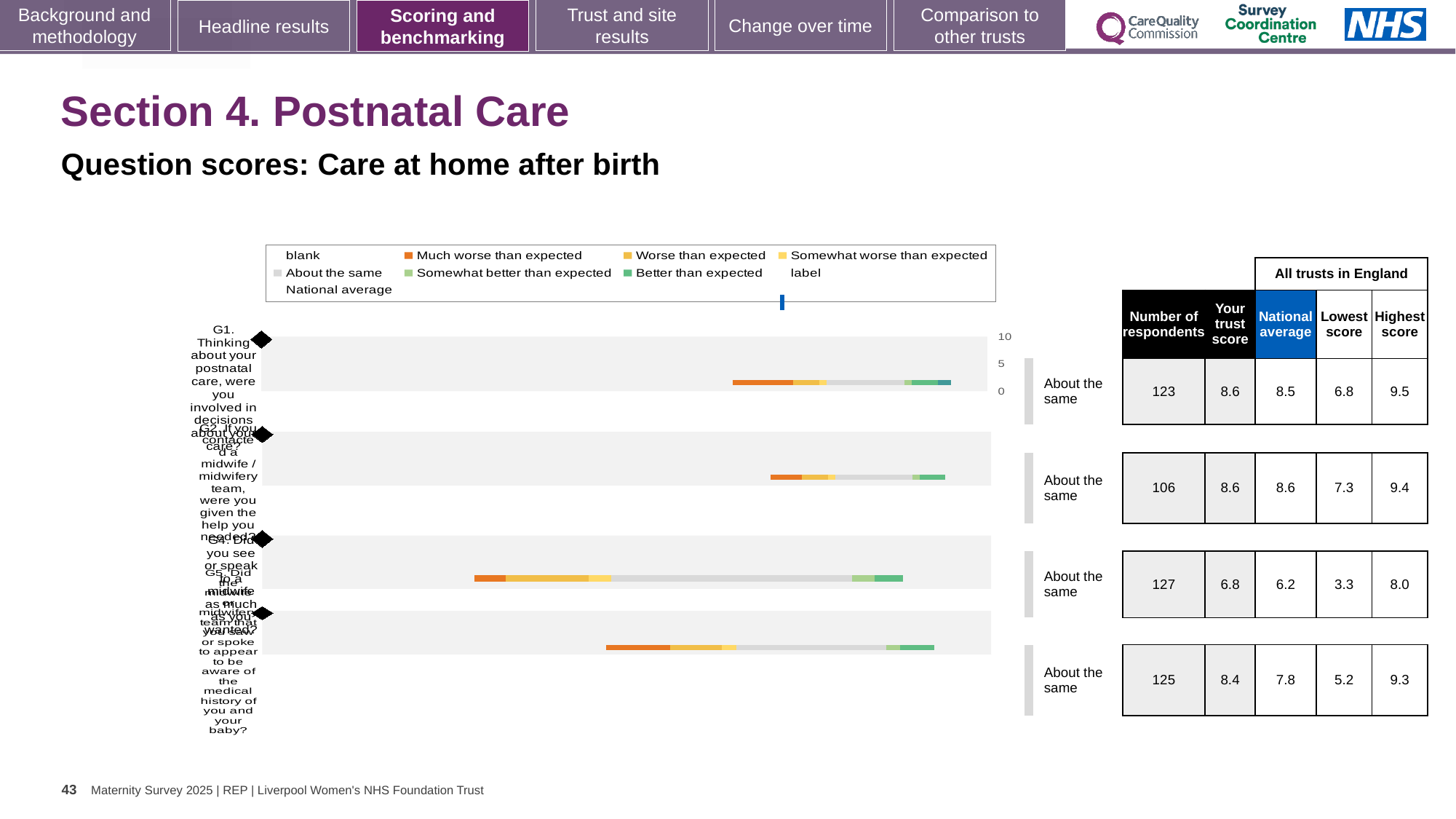
What kind of chart is used to show the question scores on this slide? Bar chart What benchmark category is shown for every question on this slide? About the same What is the highest score among all trusts in England for question G2? 9.4 What is the subtitle describing the chart on this slide? Question scores: Care at home after birth How many questions (rows) are plotted in the chart? 4 In the table next to the chart, what is the number of respondents for question G1? 123 For question G4, which is larger: the trust score or the national average? Your trust score What is the 'Your trust score' for question G4 in the table? 6.8 What is the national average for question G1? 8.5 What is the difference between the trust score and the national average for question G5? 0.6 What is the lowest score among all trusts in England for question G4? 3.3 Which question has the lowest 'Your trust score' in the table? G4